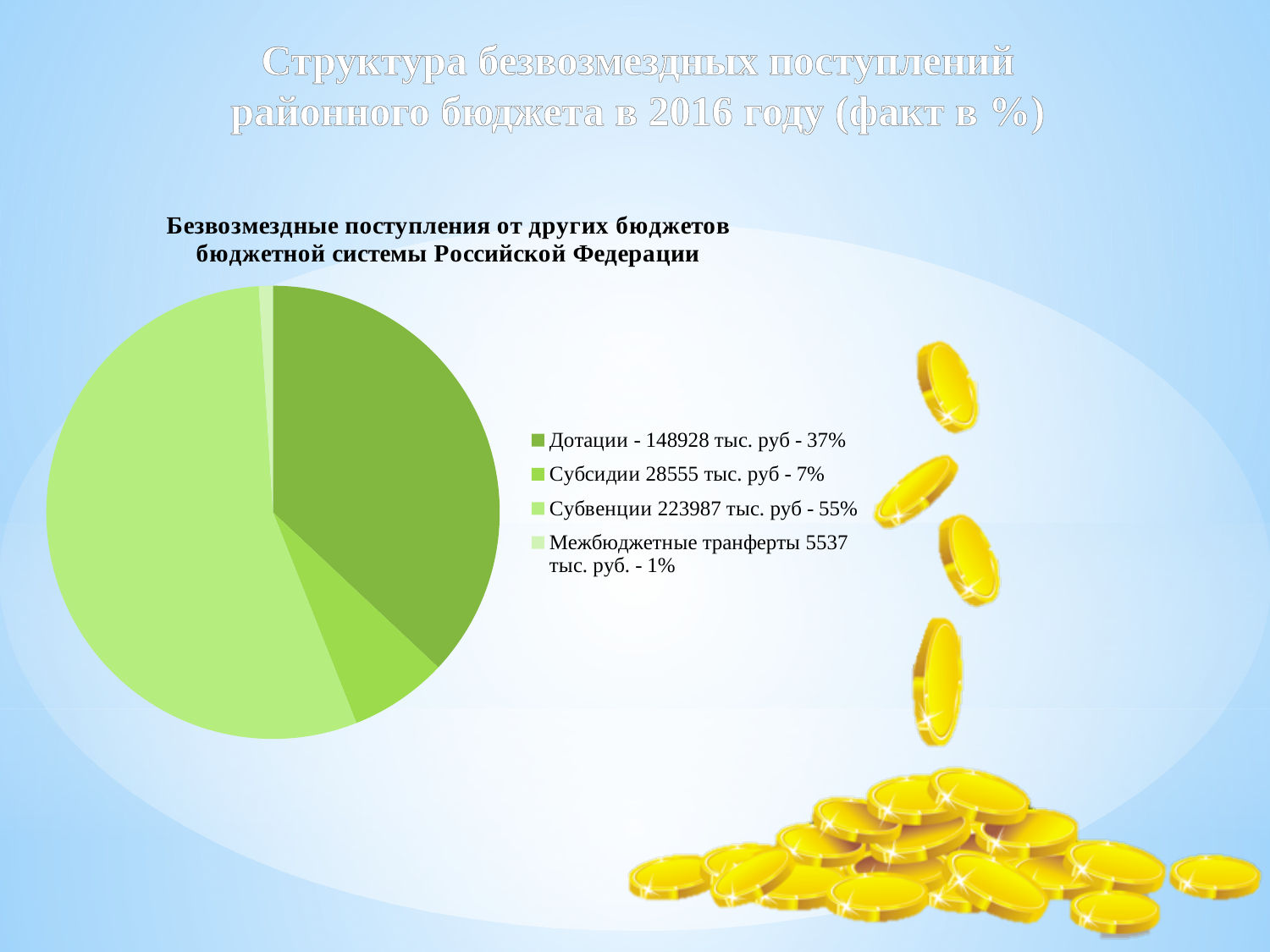
Which category has the largest share of the pie? Субвенции How many slices does the pie chart have? 4 What share of the pie does Межбюджетные транферты account for? 1% What is the amount in тыс. руб. for Дотации according to the legend? 148928 тыс. руб Which is larger, the share for Дотации or the share for Субсидии? Дотации What kind of chart is shown on the slide? pie chart Which category has the smallest share of the pie? Межбюджетные транферты What share of the pie does Субсидии account for? 7% What is the amount in тыс. руб. for Субвенции according to the legend? 223987 тыс. руб What share of the pie does Дотации account for? 37% What is the difference in percentage points between the shares of Субвенции and Дотации? 18